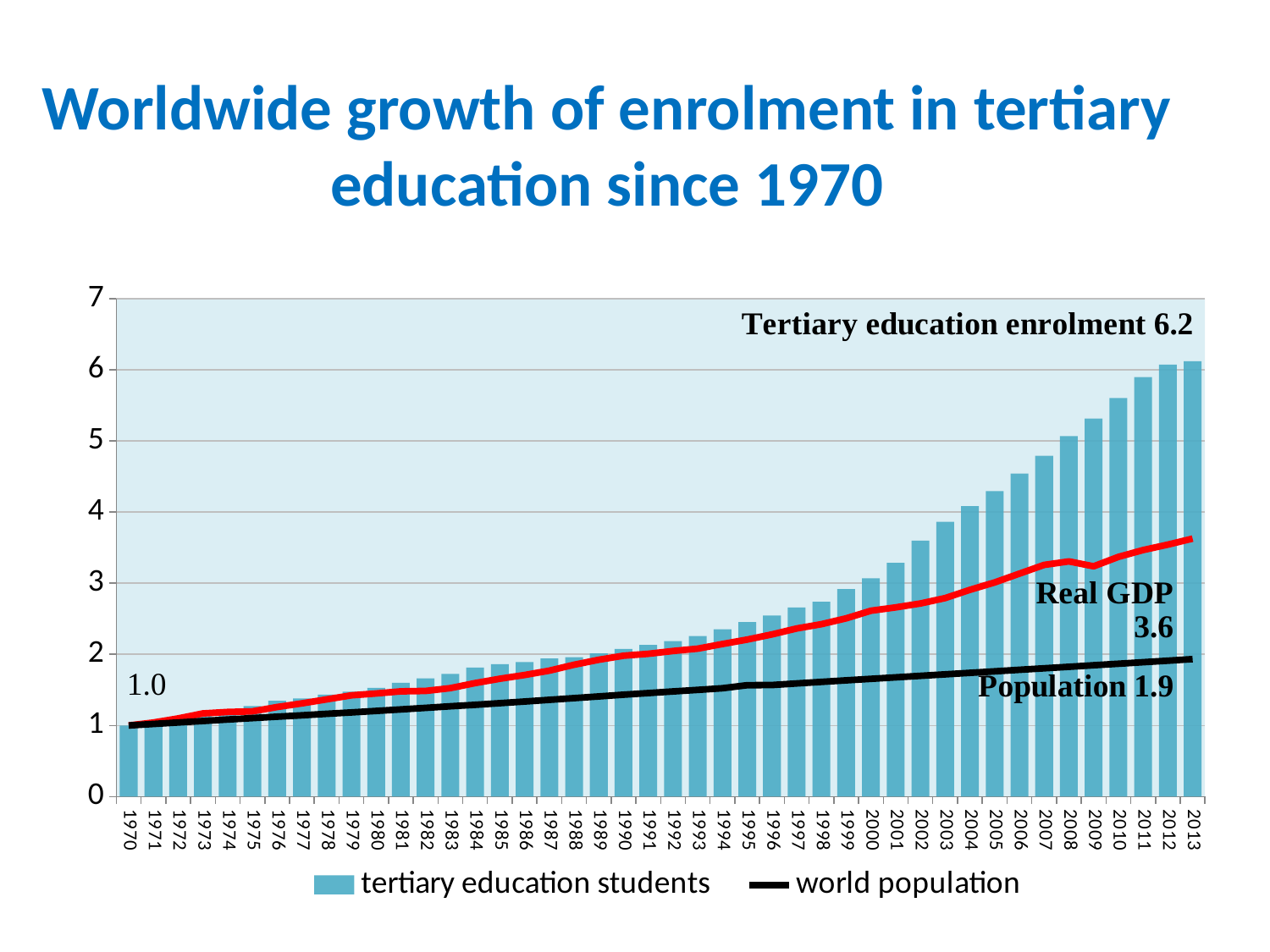
What value is labelled at the start of the series in 1970? 1.0 Is the value of the tertiary education students bar for 1980 greater or less than 2? less What is the difference between the Real GDP value (3.6) and the Population value (1.9) in 2013? 1.7 Is the value of the tertiary education students bar for 2005 greater or less than 4? greater What is the Population value labelled at the end of the black line? 1.9 What is the Real GDP value labelled at the end of the red line? 3.6 Which is larger in 2013, tertiary education enrolment or Real GDP? Tertiary education enrolment What is the title of the slide? Worldwide growth of enrolment in tertiary education since 1970 What is the tertiary education enrolment value shown for 2013? 6.2 What is the difference between the tertiary education enrolment value (6.2) and the Population value (1.9) in 2013? 4.3 How many entries does the legend list? 2 Do the tertiary education students bars rise or fall from 1970 to 2013? rise